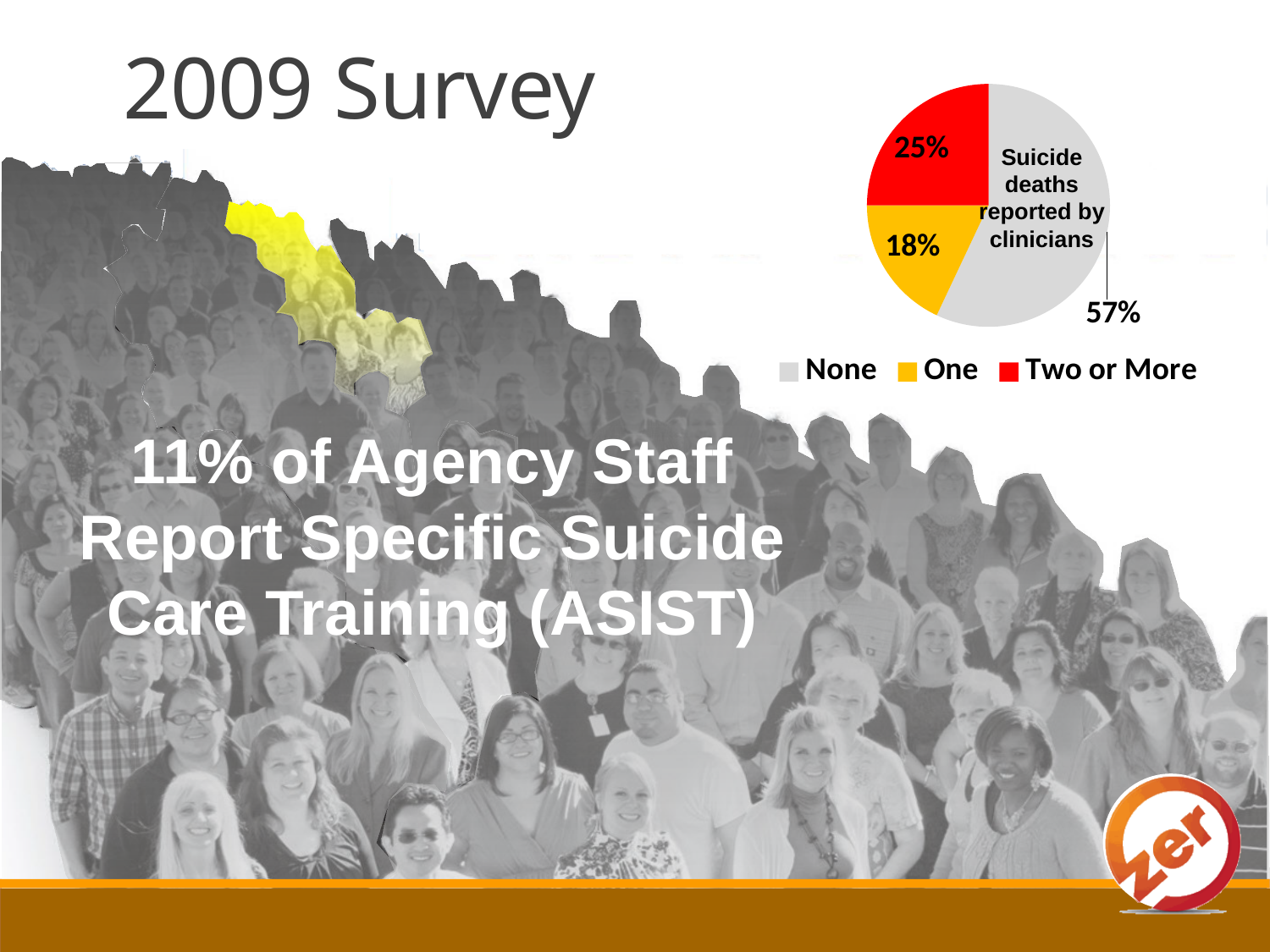
How many slices does the pie chart have? 3 What percentage of the pie is the 'One' slice? 18% What colour is the 'Two or More' slice? red Which category has the largest slice of the pie? None Which category has the smallest slice of the pie? One What percentage of the pie is the 'None' slice? 57% Which slice is larger, 'One' or 'Two or More'? Two or More How many entries does the legend list? 3 What is the difference in percentage points between the 'None' slice and the 'Two or More' slice? 32 What kind of chart is shown on the slide? pie chart What is the title of the pie chart? Suicide deaths reported by clinicians What percentage of the pie is the 'Two or More' slice? 25%